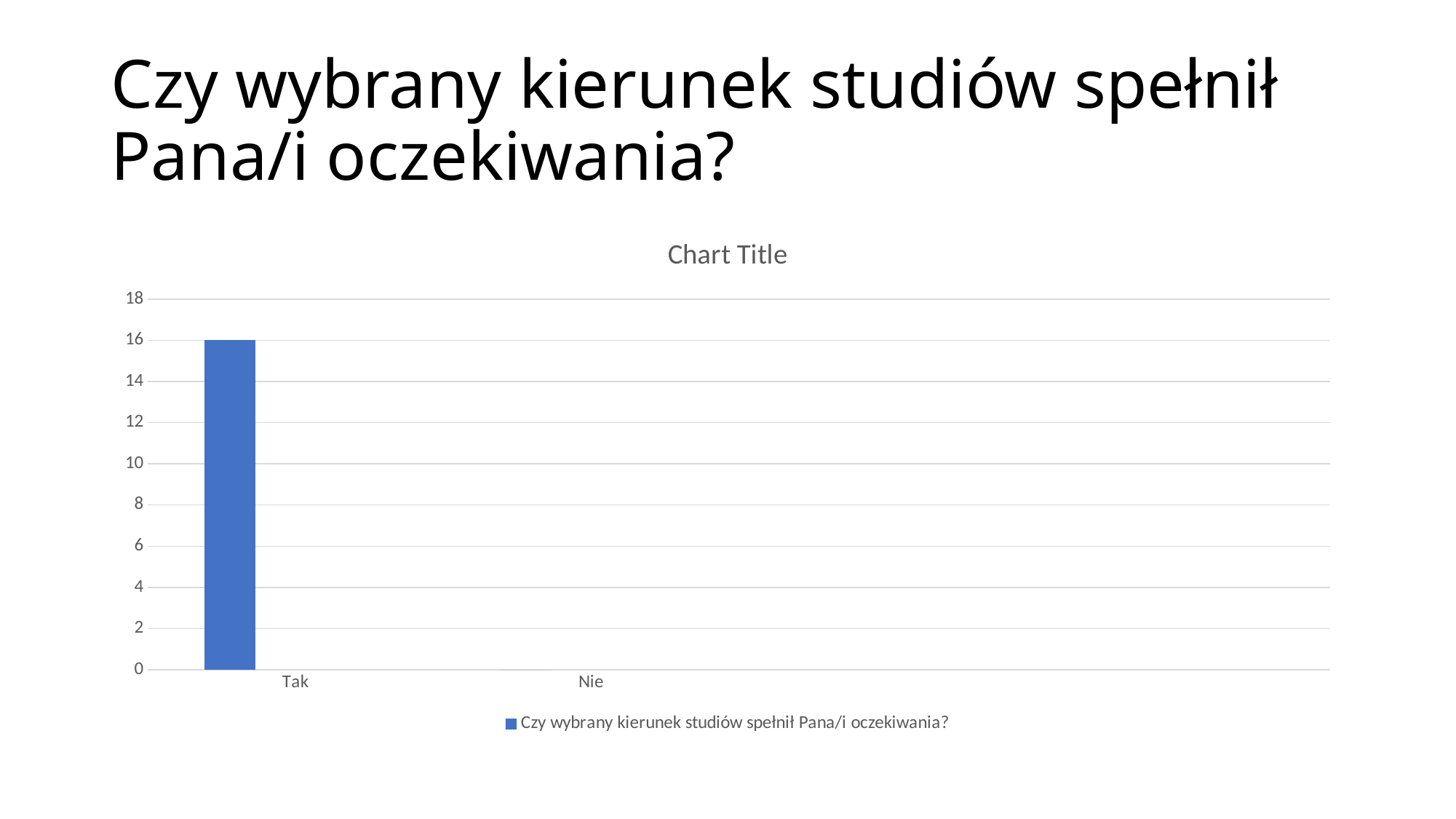
What is the difference between the values for "Tak" and "Nie"? 16 Which is larger, the value for "Tak" or the value for "Nie"? Tak How many series does the chart's legend list? 1 Which category has the highest value in the chart? Tak Is the value for "Tak" greater or less than 10? greater What is the legend entry shown below the chart? Czy wybrany kierunek studiów spełnił Pana/i oczekiwania? What is the value for "Tak" in the chart? 16 What kind of chart is shown on the slide? bar chart What is the value for "Nie" in the chart? 0 How many categories are shown on the x axis of the chart? 2 Which category has the lowest value in the chart? Nie What is the title shown above the chart? Chart Title